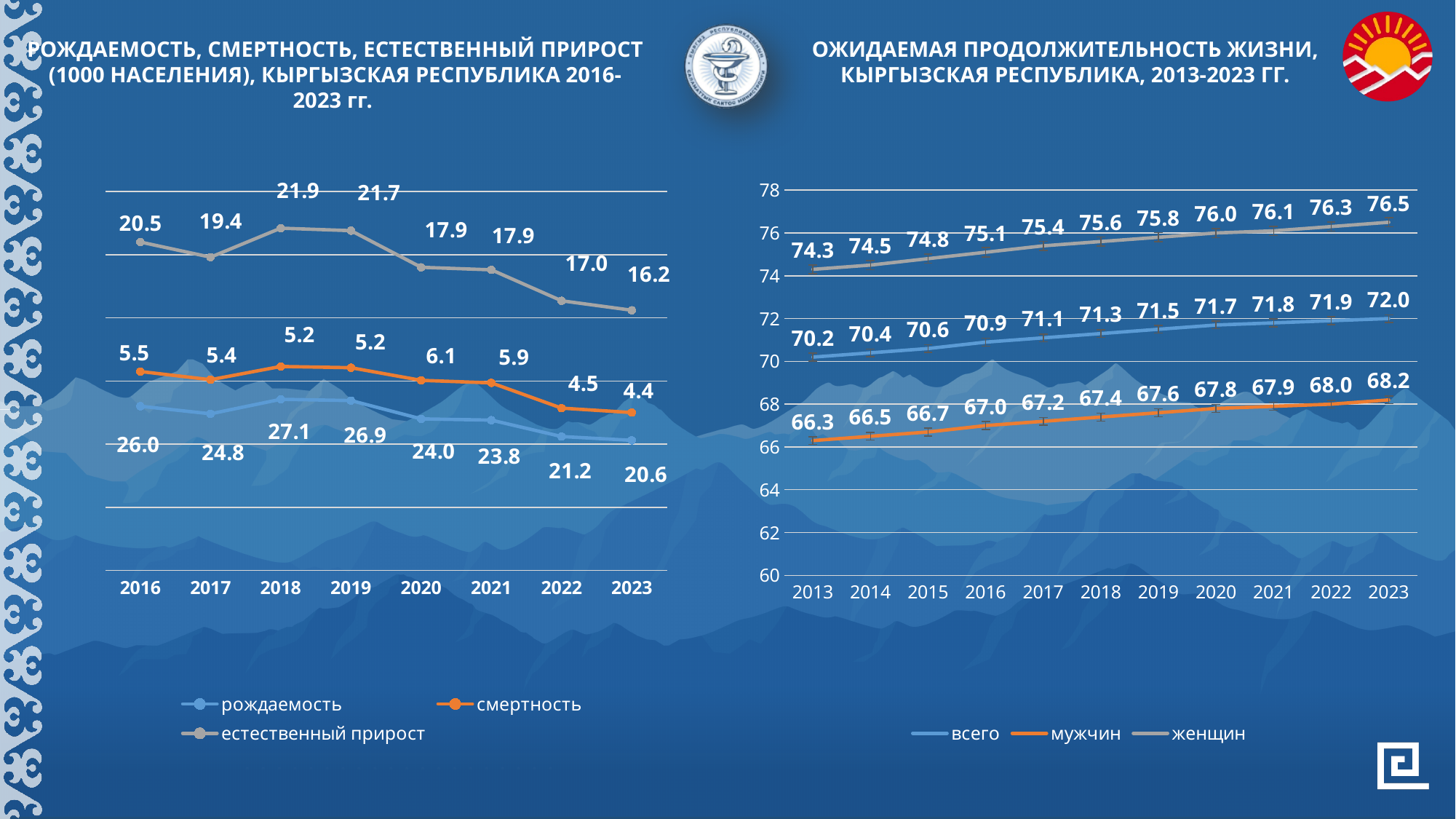
In the right chart, does the всего series rise or fall from 2013 to 2023? rises In the right chart, what is the life expectancy for мужчин in 2013? 66.3 In the left chart, what is the value of рождаемость in 2018? 27.1 In the right chart, what is the life expectancy for женщин in 2019? 75.8 In the left chart, what is the difference between рождаемость in 2016 and in 2023? 5.4 What type of chart is the right chart? line chart In the left chart, what is the value of смертность in 2020? 6.1 In the left chart, how many series does the legend list? 3 In the left chart, what is the value of естественный прирост in 2023? 16.2 In the right chart, what is the difference between женщин and мужчин in 2023? 8.3 In the left chart, in which year is смертность lowest? 2023 In the right chart, how many years are shown on the x axis? 11